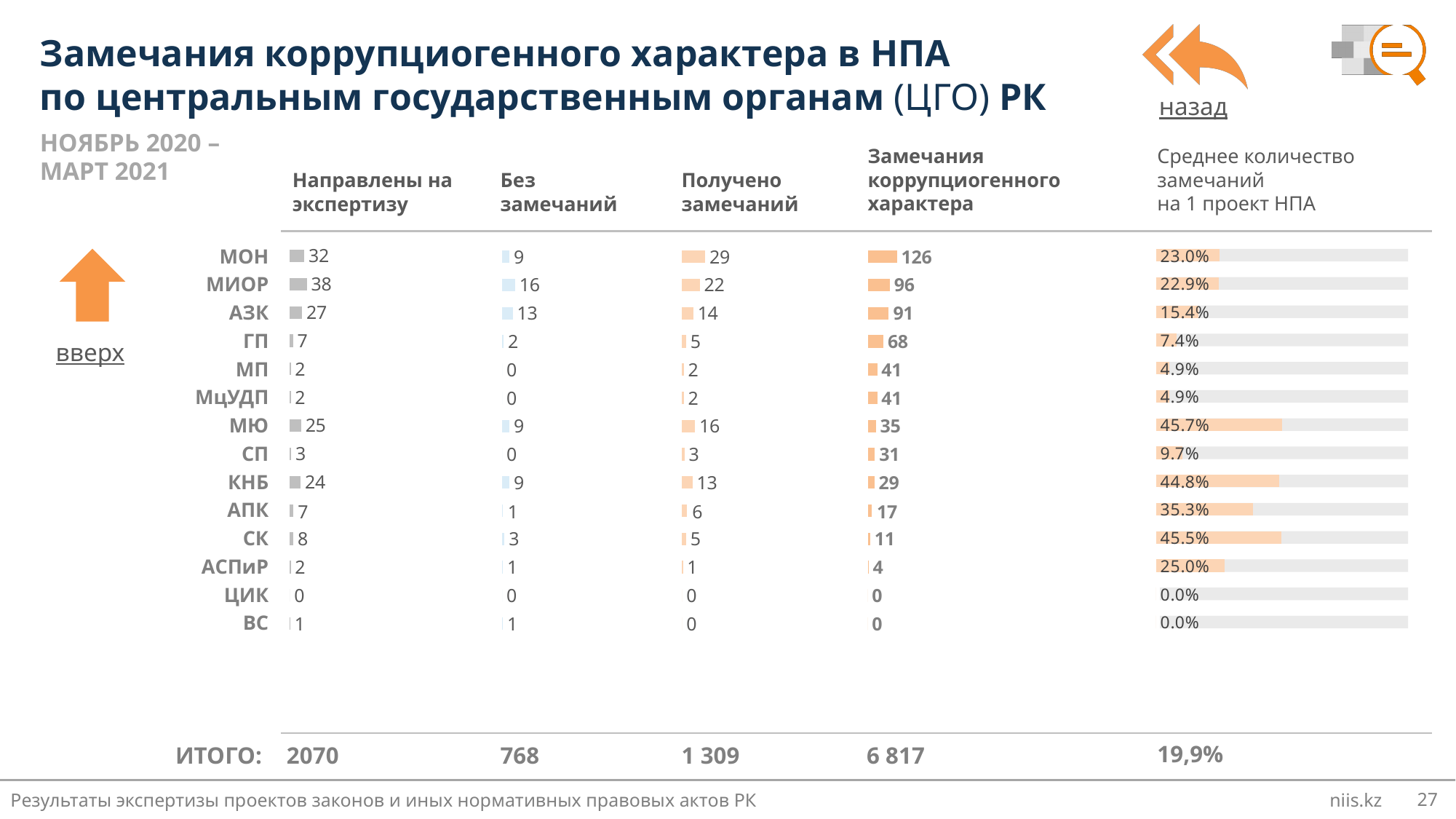
In the 'Без замечаний' column, what is the value for АЗК? 13 In the 'Получено замечаний' column, which is larger: МОН or МИОР? МОН How many state organs (rows) are listed in the chart? 14 In the 'Среднее количество замечаний на 1 проект НПА' column, what is the value for МЮ? 45.7% What is the total ('ИТОГО') for the 'Замечания коррупциогенного характера' column? 6 817 In the 'Замечания коррупциогенного характера' column, what is the difference between МОН and МИОР? 30 What type of chart is used to show the values in each column? bar chart In the 'Среднее количество замечаний на 1 проект НПА' column, which organ has the highest value? МЮ In the 'Замечания коррупциогенного характера' column, what is the value for МОН? 126 In the 'Направлены на экспертизу' column, what is the value for МИОР? 38 In the 'Направлены на экспертизу' column, which organ has the highest value? МИОР In the 'Замечания коррупциогенного характера' column, which organ has the highest value? МОН